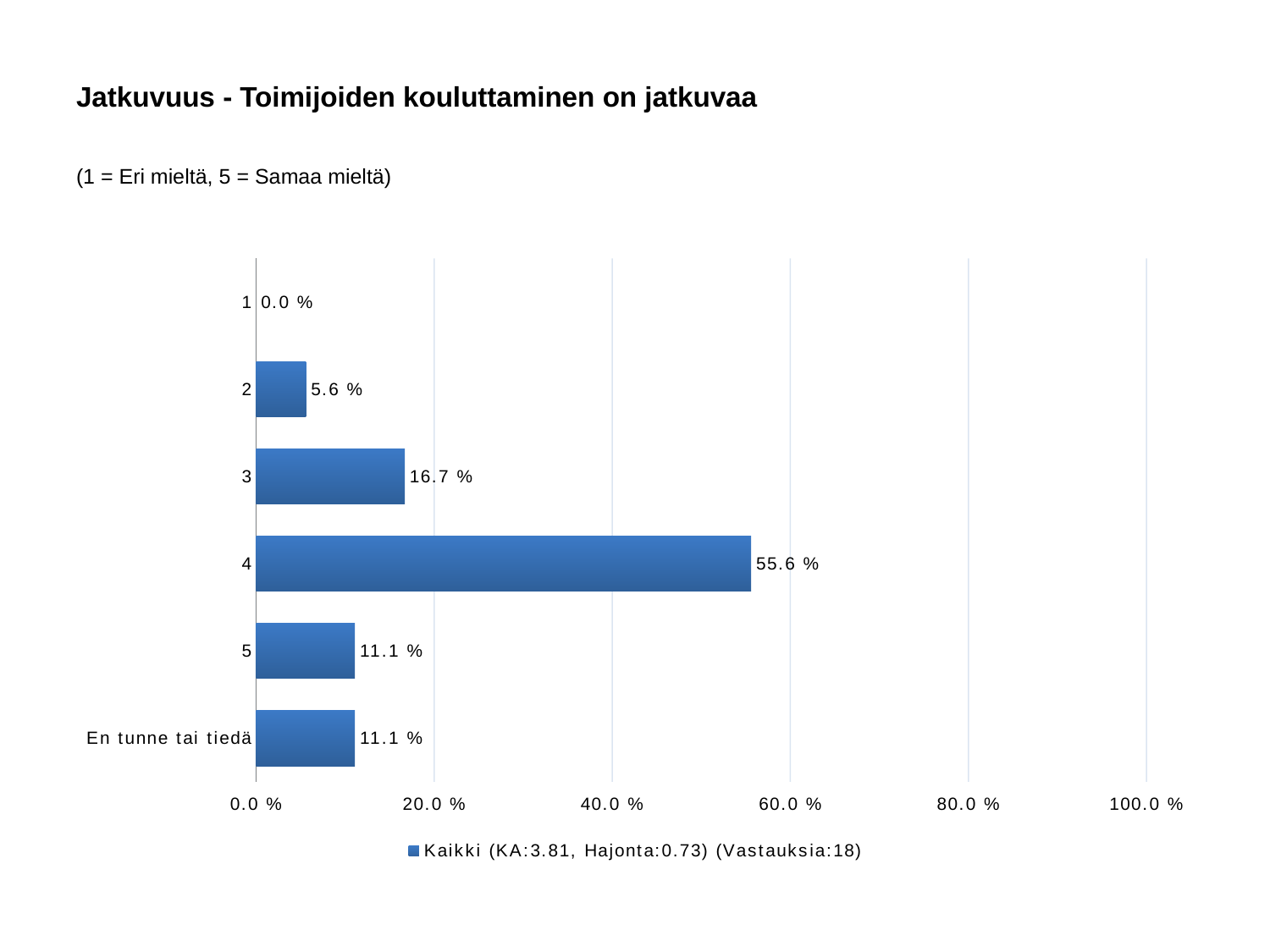
What is the value for category 1? 0.0 % Which category has the highest value? 4 Is the value for category 4 greater or less than 40.0 %? greater What is the value for category 4? 55.6 % Which is larger, the value for category 3 or the value for category 5? 3 What is the value for category 2? 5.6 % What is the value for 'En tunne tai tiedä'? 11.1 % What kind of chart is shown on the slide? bar chart How many responses (Vastauksia) does the legend report? 18 What is the difference between the values for category 4 and category 3? 38.9 % How many categories are shown on the chart? 6 Which category has the lowest value? 1